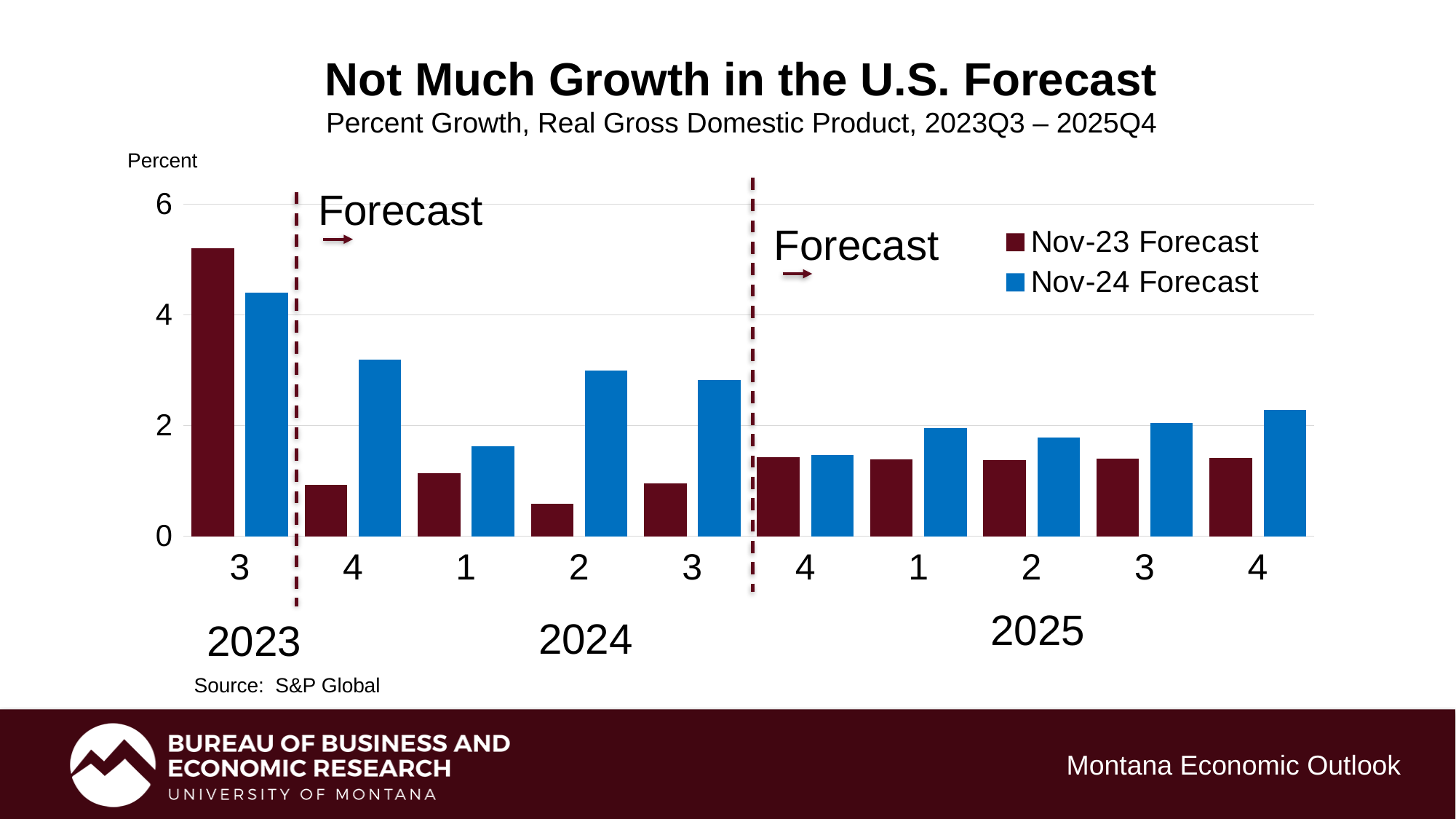
Is the Nov-23 Forecast value for 2024 Q2 greater or less than 1? less Which quarter has the lowest Nov-23 Forecast value? 2024 Q2 How many quarters are plotted along the x axis? 10 Which quarter has the highest Nov-24 Forecast value? 2023 Q3 What is the source cited for the chart? S&P Global Is the Nov-24 Forecast value for 2025 Q4 greater or less than 2? greater How many series does the legend list? 2 For 2024 Q2, which is larger: the Nov-23 Forecast or the Nov-24 Forecast? Nov-24 Forecast What kind of chart is shown on the slide? Bar chart Which quarter has the highest Nov-23 Forecast value? 2023 Q3 Is the Nov-24 Forecast value for 2023 Q4 greater or less than 2? greater